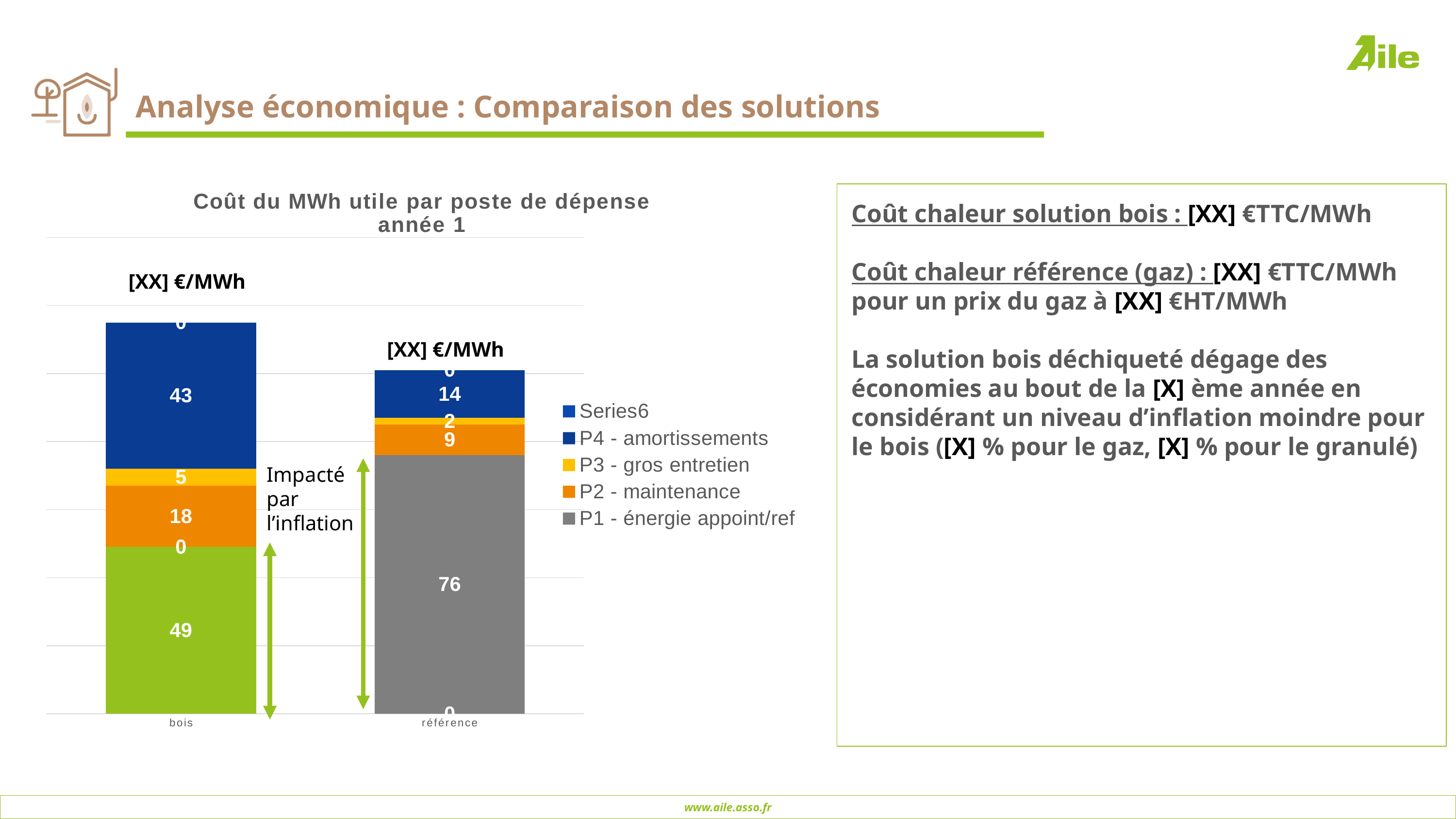
What is the difference between the P4 - amortissements values for bois and référence? 29 What kind of chart is shown on the slide? Stacked bar chart What is the value of P2 - maintenance for the bois bar? 18 Which bar has the larger value for P4 - amortissements, bois or référence? bois What is the value of P1 - énergie appoint/ref for the référence bar? 76 How many series does the chart legend list? 5 What is the value of P4 - amortissements for the référence bar? 14 What is the difference between the P2 - maintenance values for bois and référence? 9 How many categories are shown on the x axis of the chart? 2 What is the value of P2 - maintenance for the référence bar? 9 What is the title of the chart? Coût du MWh utile par poste de dépense année 1 What is the value of P3 - gros entretien for the bois bar? 5